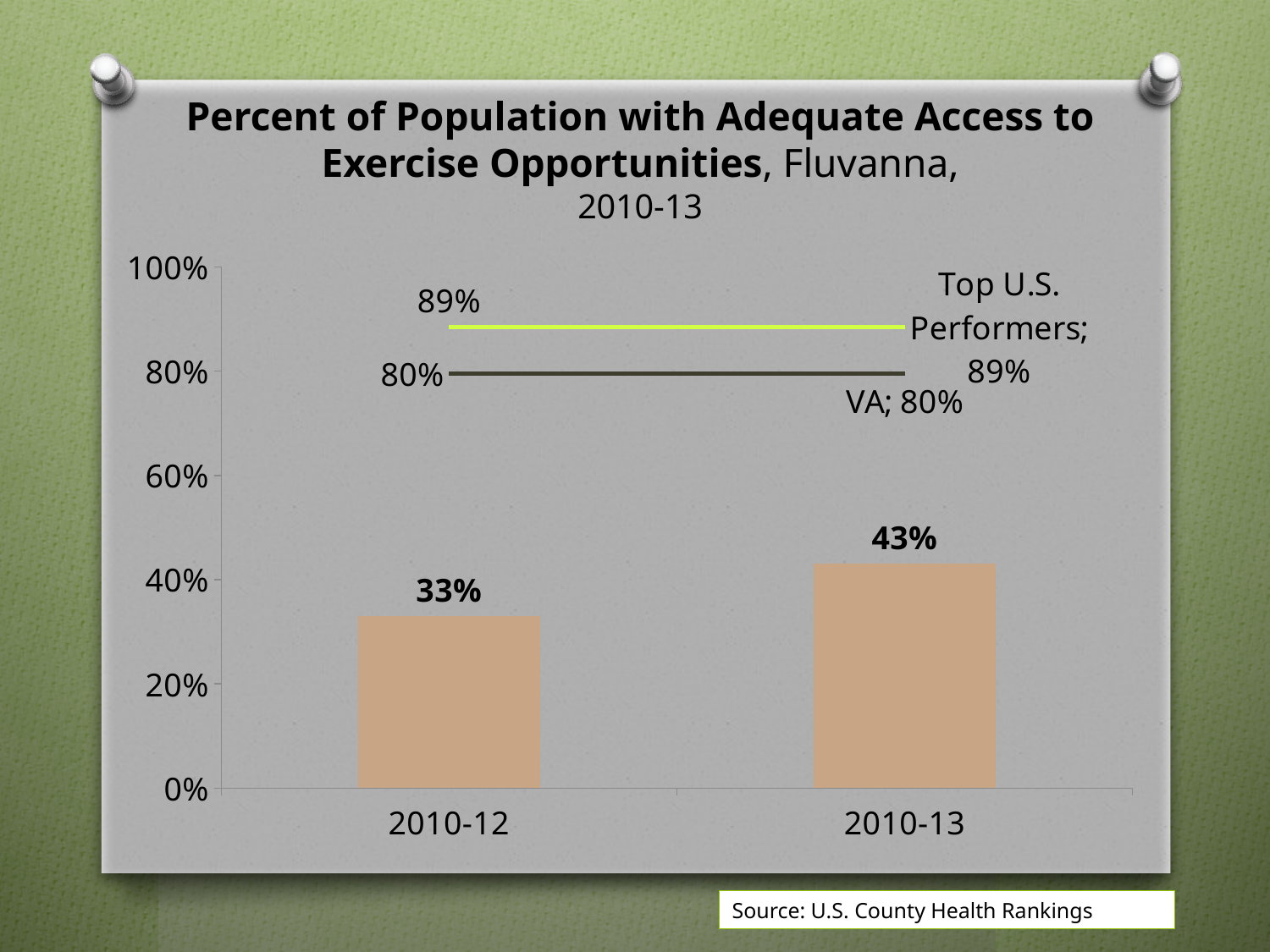
What value is shown for Top U.S. Performers? 89% What is the source cited for the chart? U.S. County Health Rankings How many bars are plotted in the chart? 2 What is the value for 2010-13? 43% What value is shown for VA? 80% What is the difference between the Top U.S. Performers value and the VA value? 9% What kind of chart is this? combination bar and line chart Is the value for 2010-13 greater or less than 40%? greater Do the bar values rise or fall from 2010-12 to 2010-13? rise Which period has the higher value, 2010-12 or 2010-13? 2010-13 What is the difference between the 2010-13 value and the 2010-12 value? 10% What is the value for 2010-12? 33%